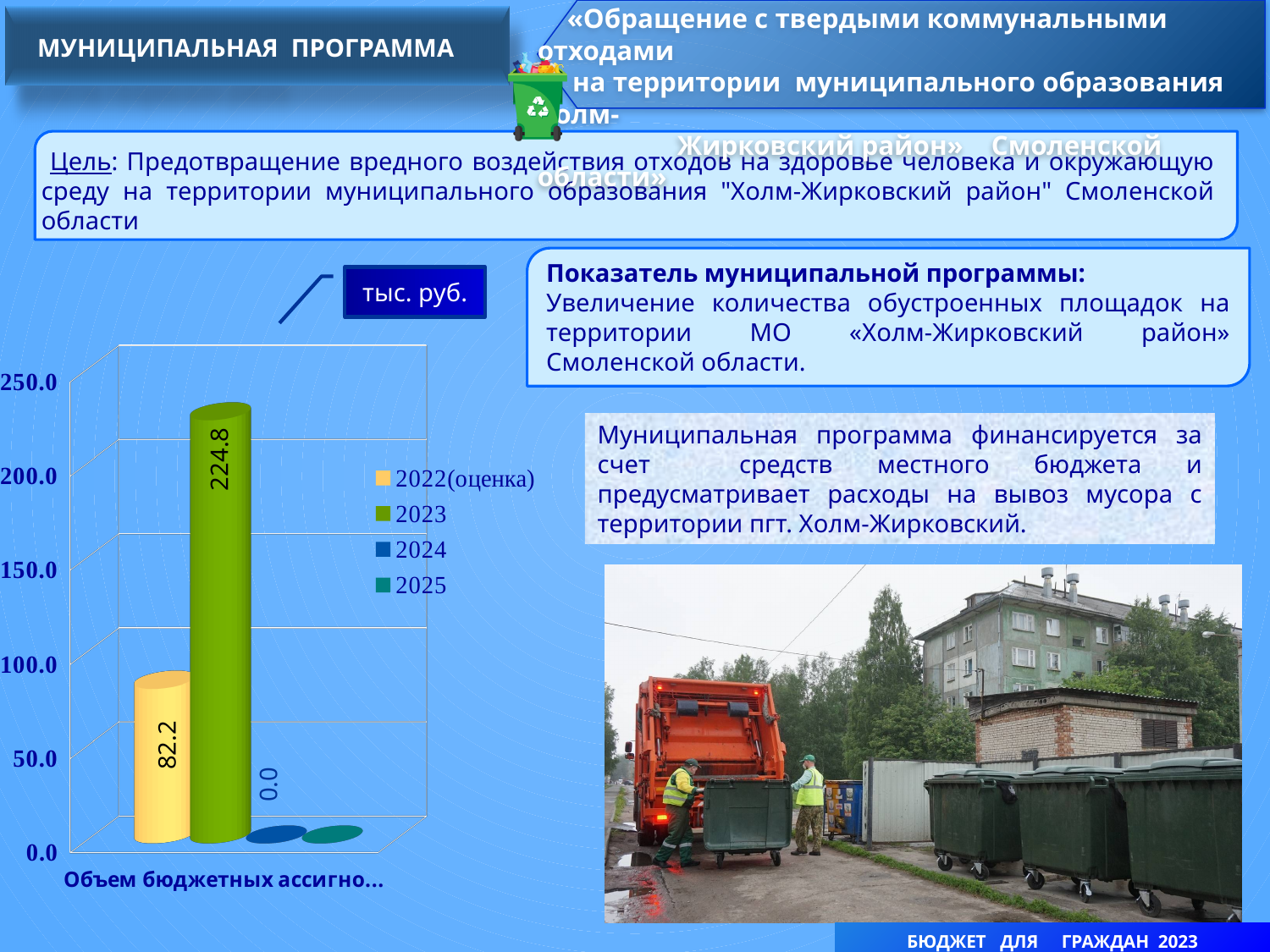
Which series has the highest value in the chart? 2023 Is the value for 2023 greater or less than 200.0? greater Is the value for 2022(оценка) greater or less than 100.0? less What is the difference between the 2023 value and the 2022(оценка) value? 142.6 Which is larger, the value for 2023 or the value for 2022(оценка)? 2023 What kind of chart is shown on the slide? bar chart What is the value for the 2023 series in the chart? 224.8 How many series does the chart legend list? 4 What is the highest value shown on the chart's vertical axis? 250.0 What is the value labelled for the 2024 series in the chart? 0.0 What is the value for the 2022(оценка) series in the chart? 82.2 What unit is indicated in the box above the chart? тыс. руб.